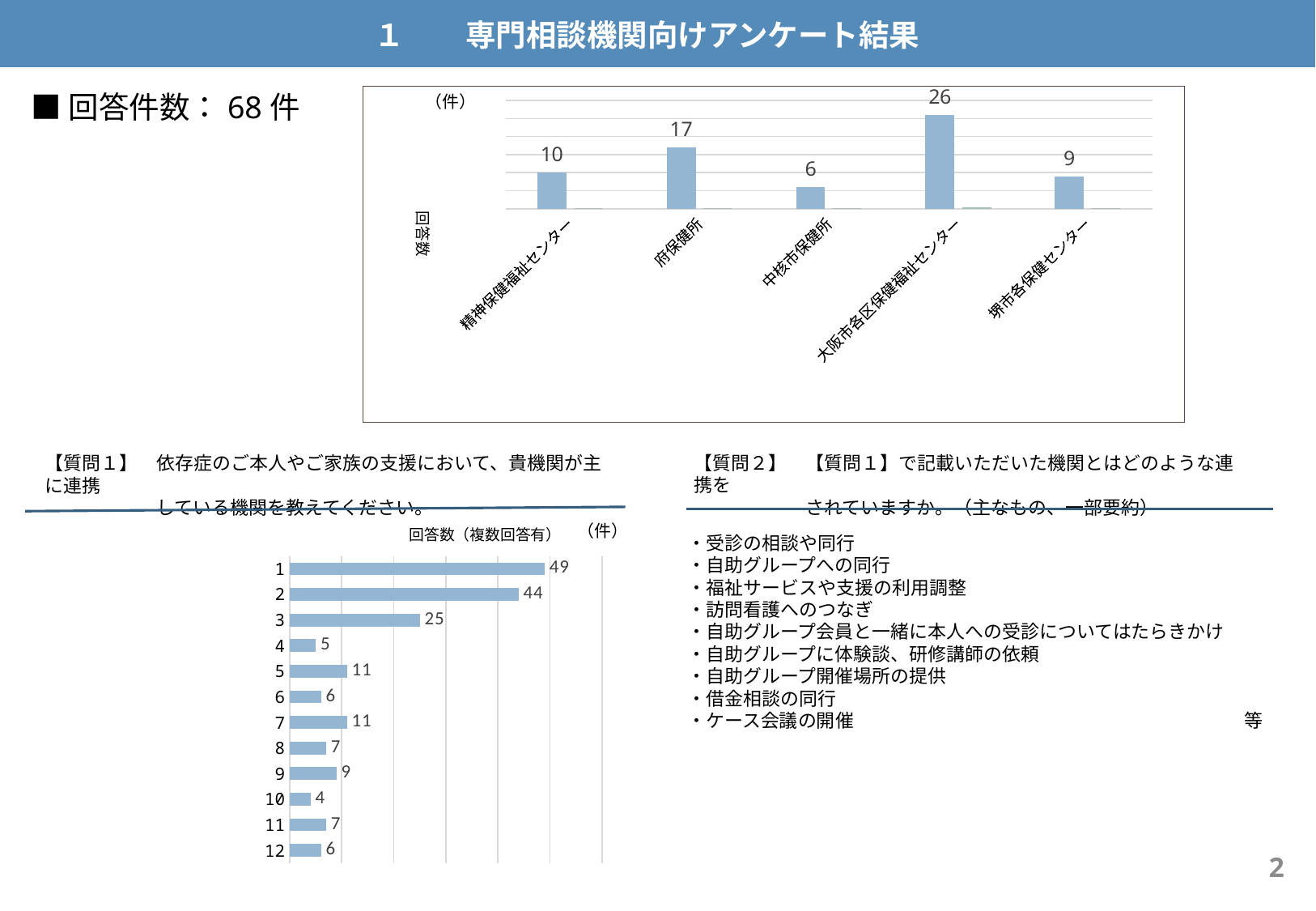
What kind of chart is the top chart? Bar chart In the top chart, how many responses are shown for 大阪市各区保健福祉センター? 26 In the top chart, which category has the highest number of responses? 大阪市各区保健福祉センター In the bottom-left chart titled 回答数（複数回答有）, what is the value for category 3? 25 In the top chart, how many categories are plotted? 5 In the top chart, which category has the lowest number of responses? 中核市保健所 In the bottom-left chart titled 回答数（複数回答有）, which is larger, the value for category 2 or category 3? Category 2 In the top chart, how many responses are shown for 府保健所? 17 In the bottom-left chart titled 回答数（複数回答有）, how many categories are plotted? 12 In the top chart, what is the difference between the responses for 精神保健福祉センター and 堺市各保健センター? 1 In the bottom-left chart titled 回答数（複数回答有）, which category has the lowest value? 10 In the bottom-left chart titled 回答数（複数回答有）, which category has the highest value? 1